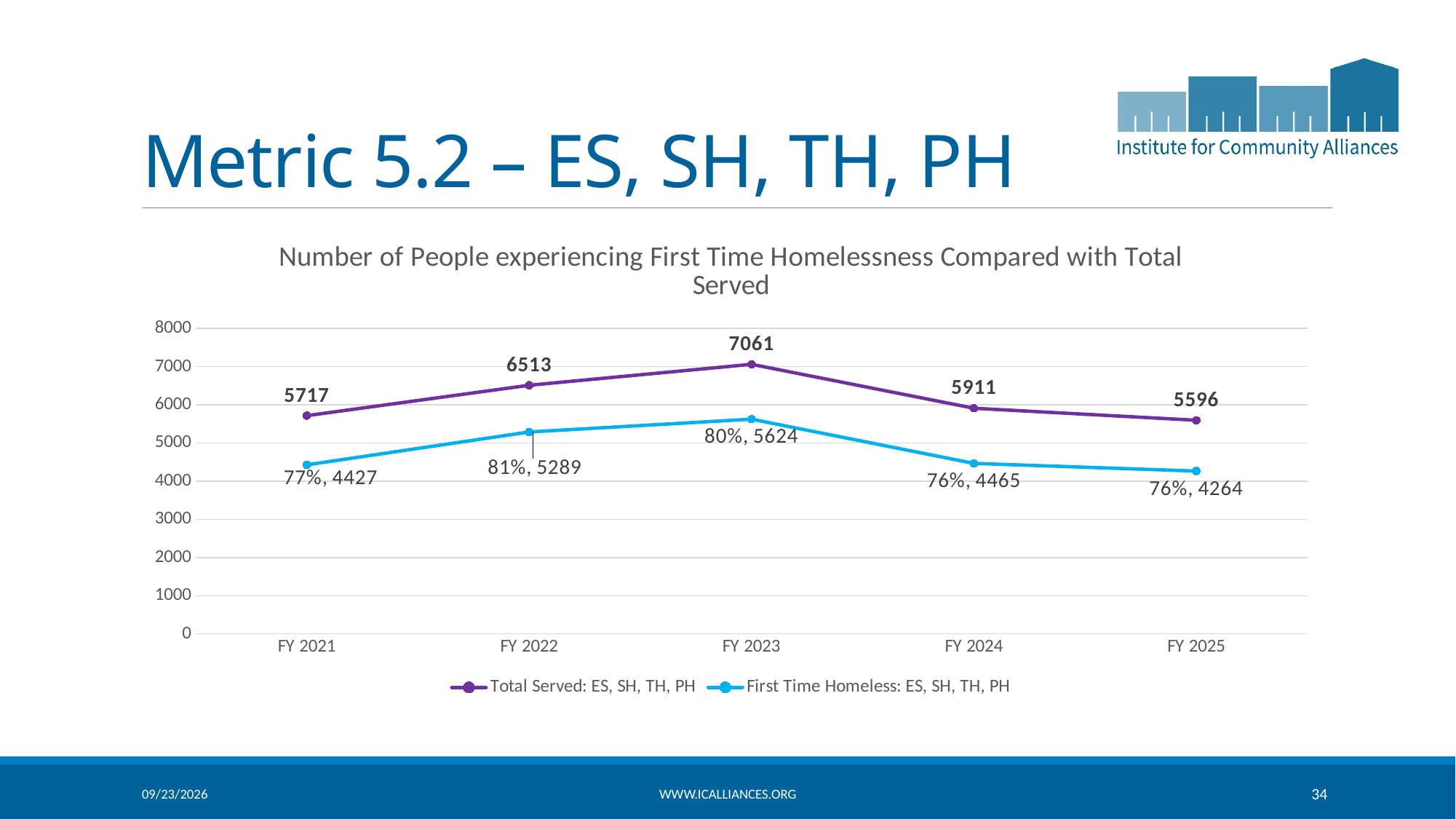
What is the Total Served: ES, SH, TH, PH value for FY 2023? 7061 What is the First Time Homeless: ES, SH, TH, PH value for FY 2021? 4427 How many fiscal years are plotted on the x axis? 5 Which is larger: Total Served in FY 2021 or Total Served in FY 2025? FY 2021 In which fiscal year is First Time Homeless: ES, SH, TH, PH lowest? FY 2025 What kind of chart is shown on the slide? line chart What is the difference between Total Served and First Time Homeless in FY 2024? 1446 How many series does the legend list? 2 Does Total Served: ES, SH, TH, PH rise or fall from FY 2023 to FY 2025? fall What percentage label is shown for First Time Homeless in FY 2022? 81% In which fiscal year is Total Served: ES, SH, TH, PH highest? FY 2023 Is the First Time Homeless value for FY 2023 greater or less than 5000? greater